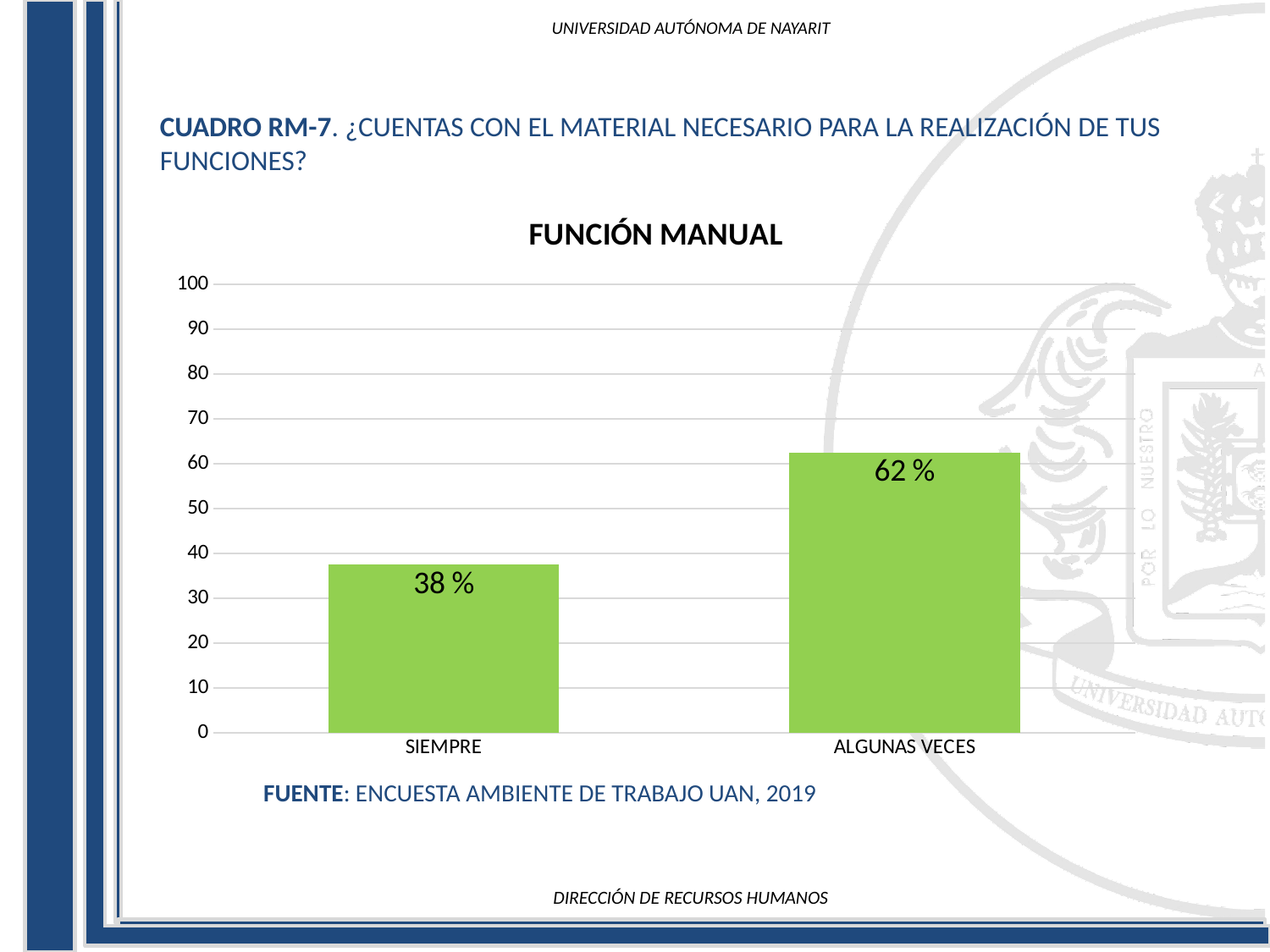
What is the difference between the values for ALGUNAS VECES and SIEMPRE? 24 % Which is larger, the value for SIEMPRE or the value for ALGUNAS VECES? ALGUNAS VECES What is the title of the chart? FUNCIÓN MANUAL What is the value for SIEMPRE? 38 % What kind of chart is shown? bar chart How many categories are shown on the x axis? 2 Which category has the lowest value? SIEMPRE Is the value for ALGUNAS VECES greater or less than 50? greater What is the maximum value shown on the y axis? 100 Is the value for SIEMPRE greater or less than 40? less What is the value for ALGUNAS VECES? 62 % Which category has the highest value? ALGUNAS VECES